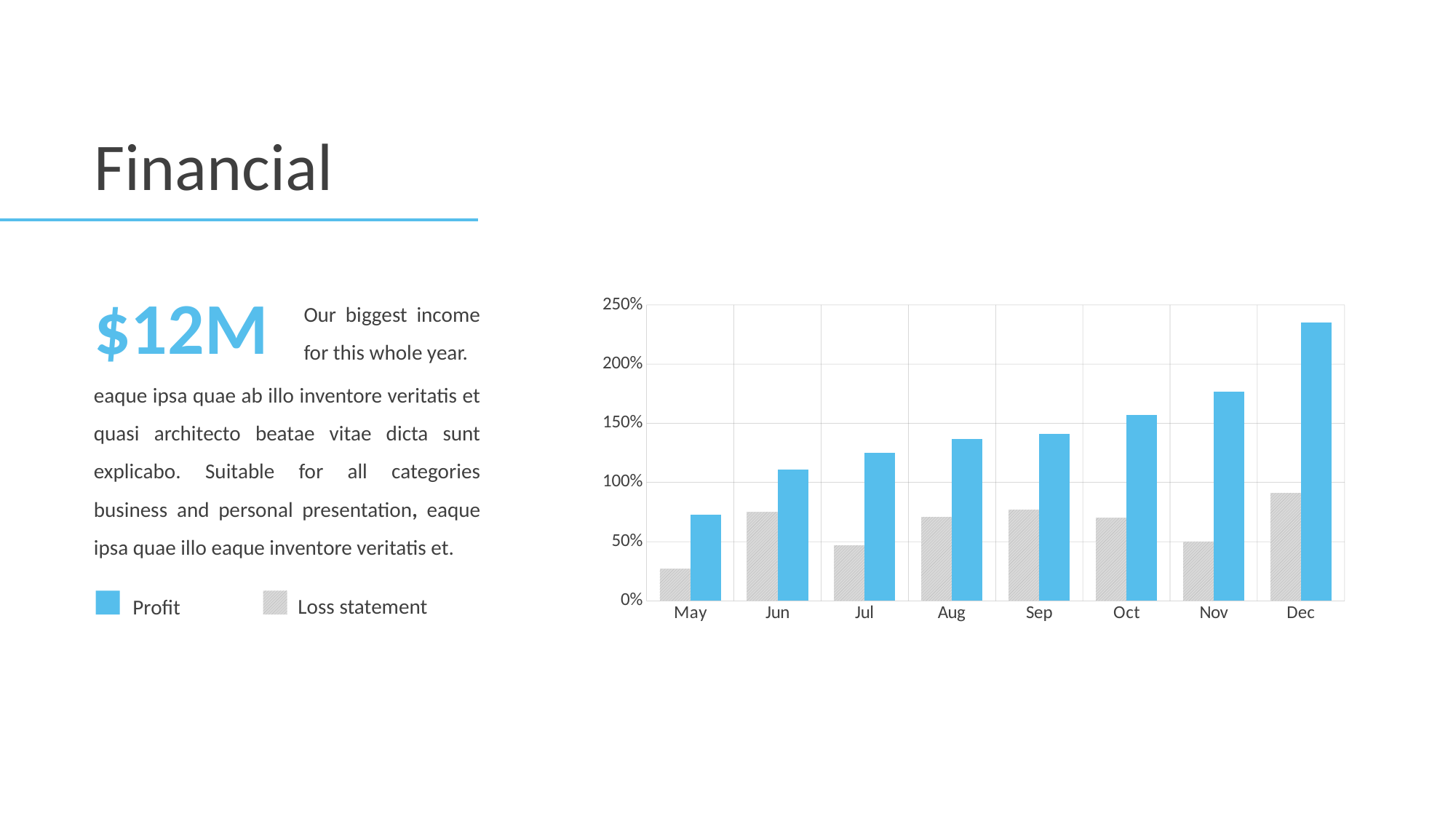
Which month has the highest Profit value? Dec Which month has the highest Loss statement value? Dec What kind of chart is shown on the slide? bar chart How many months are shown on the x axis of the chart? 8 Which month has the lowest Profit value? May How many series does the chart's legend list? 2 Is the Profit value for Dec greater or less than 200%? greater Which colour represents the Profit series in the legend? blue Which is larger, the Profit value for Jul or the Profit value for Jun? Jul Which month has the lowest Loss statement value? May Do the Profit values rise or fall from May to Dec? rise